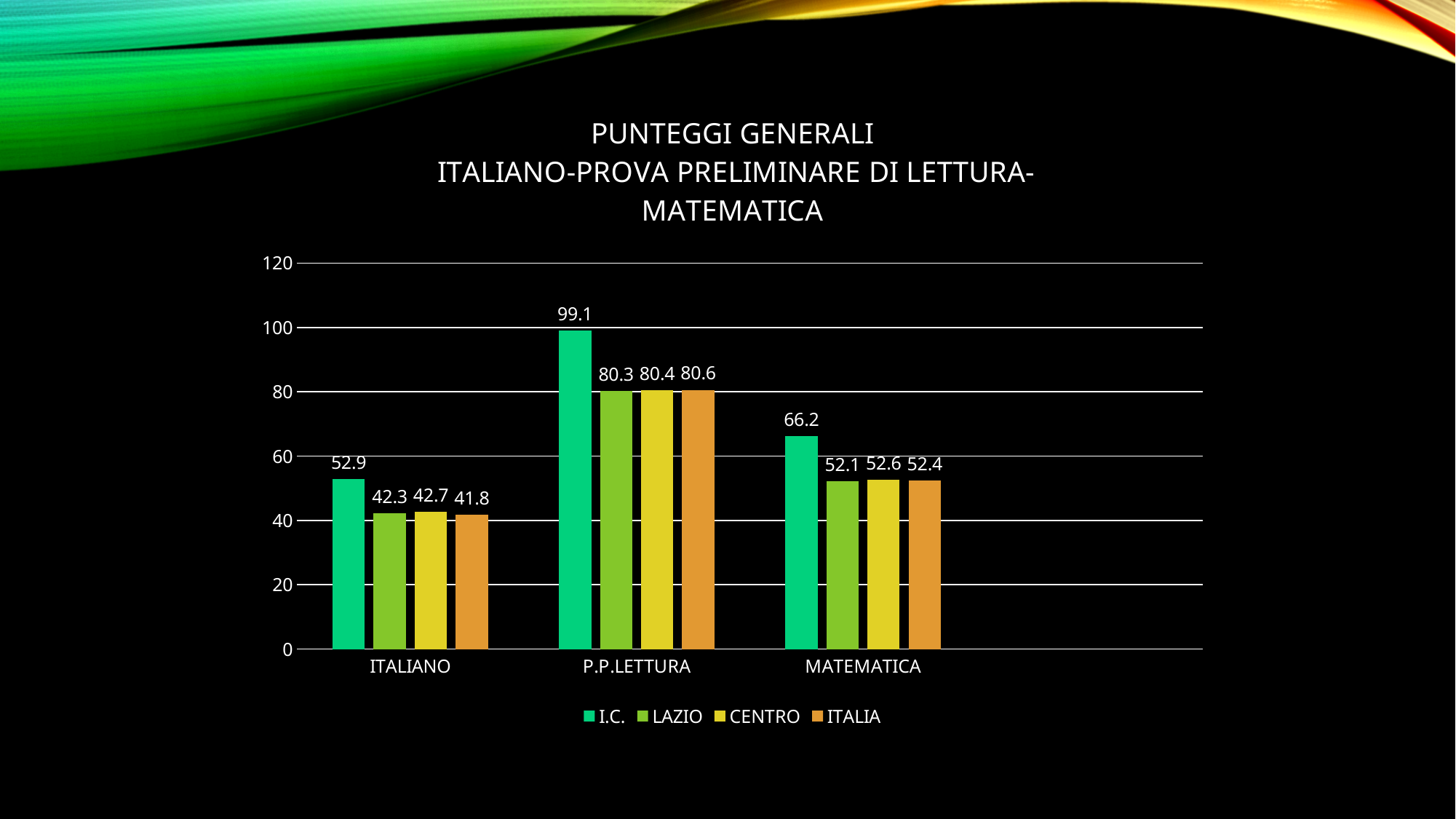
Which series has the lowest value for ITALIANO? ITALIA How many series does the legend list? 4 How many categories are shown on the x axis? 3 Which is larger for ITALIANO: the I.C. value or the CENTRO value? I.C. What is the first line of the chart title? PUNTEGGI GENERALI What kind of chart is shown on the slide? Bar chart Which category has the highest I.C. value? P.P.LETTURA What is the ITALIA value for ITALIANO? 41.8 What is the CENTRO value for MATEMATICA? 52.6 What is the I.C. value for P.P.LETTURA? 99.1 What is the LAZIO value for P.P.LETTURA? 80.3 What is the difference between the I.C. and LAZIO values for MATEMATICA? 14.1